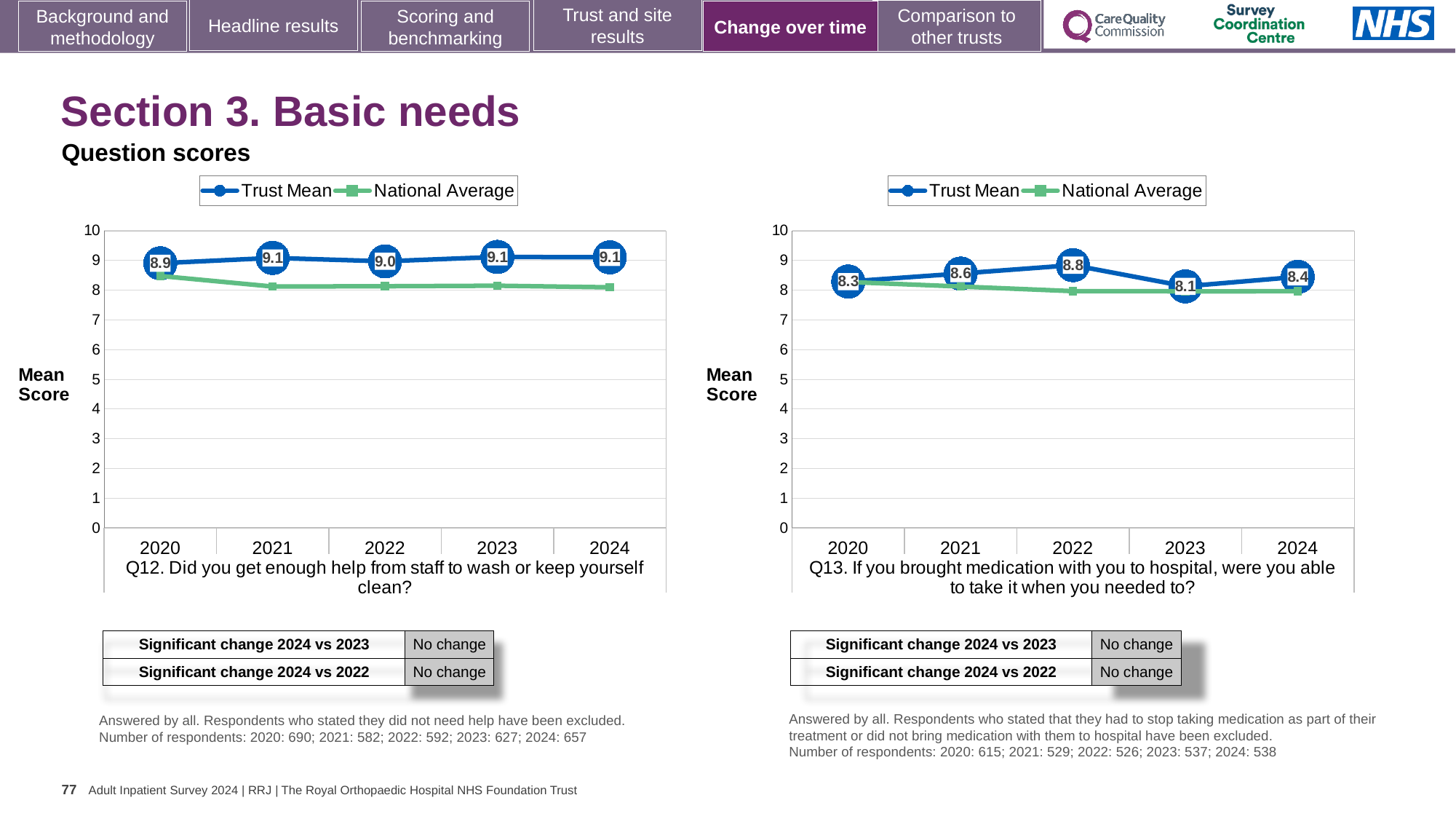
In the Q12 chart on the left, is the Trust Mean for 2021 larger or smaller than the Trust Mean for 2020? larger In the Q13 chart on the right, is the National Average for 2022 greater or less than 9? less In the Q13 chart on the right, what is the Trust Mean for 2024? 8.4 In the Q13 chart on the right, what is the difference between the Trust Mean for 2022 and 2023? 0.7 How many years are plotted on the x axis of the Q12 chart on the left? 5 In the Q12 chart on the left, which year has the lowest Trust Mean? 2020 In the Q13 chart on the right, which year has the highest Trust Mean? 2022 In the Q13 chart on the right, what is the Trust Mean for 2022? 8.8 In the Q12 chart on the left, what is the Trust Mean for 2022? 9.0 In the Q13 chart on the right, which year has the lowest Trust Mean? 2023 How many series does the legend of the Q13 chart on the right list? 2 In the Q12 chart on the left, what is the Trust Mean for 2020? 8.9